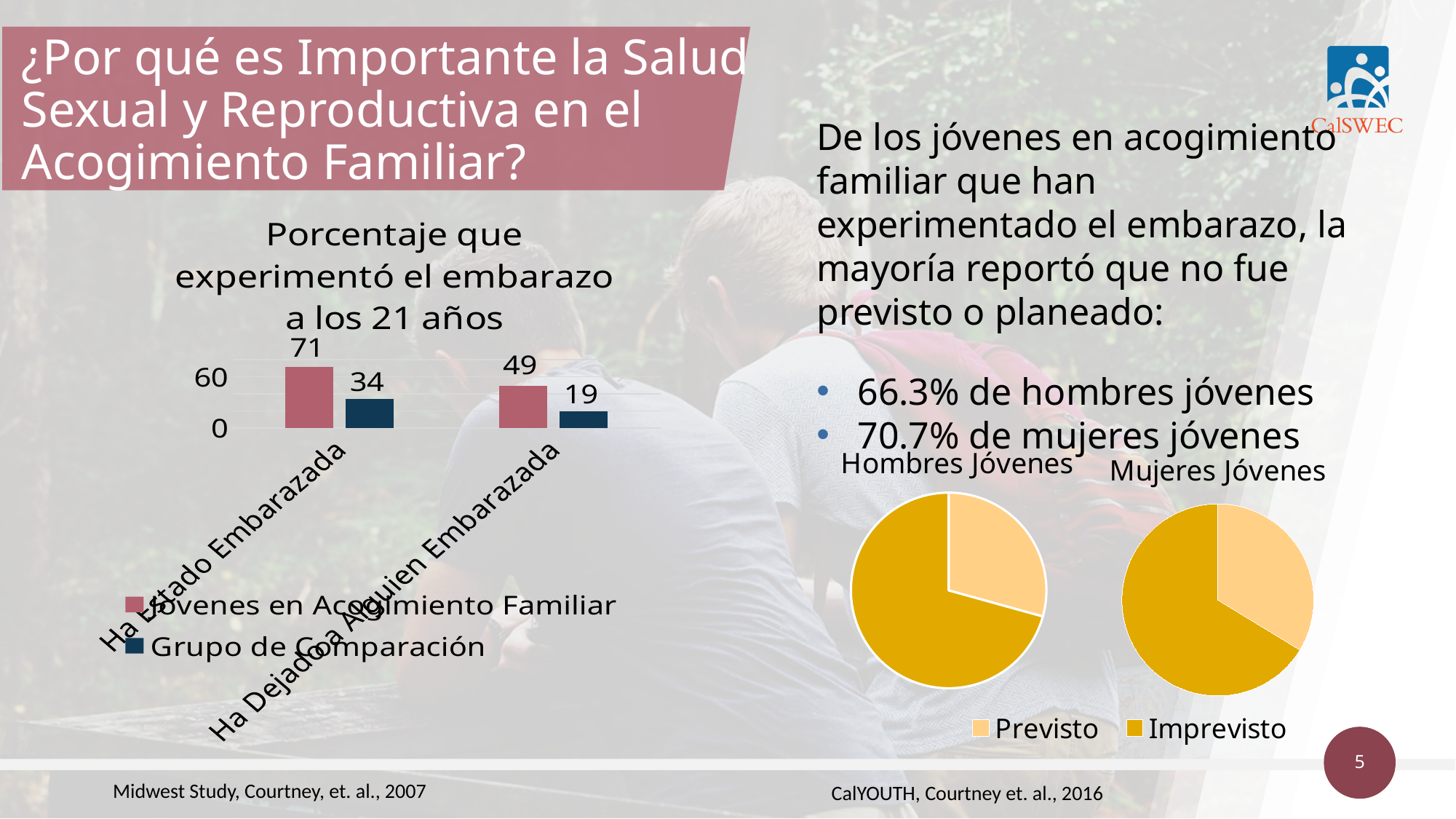
In the bar chart 'Porcentaje que experimentó el embarazo a los 21 años', what is the difference between Jóvenes en Acogimiento Familiar and Grupo de Comparación in the 'Ha Estado Embarazada' category? 37 In the bar chart 'Porcentaje que experimentó el embarazo a los 21 años', what is the value for Jóvenes en Acogimiento Familiar in the 'Ha Dejado a Alguien Embarazada' category? 49 What kind of chart is the 'Mujeres Jóvenes' chart on the right of the slide? Pie chart In the pie chart 'Hombres Jóvenes', which slice is larger, Previsto or Imprevisto? Imprevisto In the bar chart 'Porcentaje que experimentó el embarazo a los 21 años', what is the value for Jóvenes en Acogimiento Familiar in the 'Ha Estado Embarazada' category? 71 In the bar chart 'Porcentaje que experimentó el embarazo a los 21 años', how many series does the legend list? 2 In the bar chart 'Porcentaje que experimentó el embarazo a los 21 años', what is the difference between Jóvenes en Acogimiento Familiar and Grupo de Comparación in the 'Ha Dejado a Alguien Embarazada' category? 30 In the bar chart 'Porcentaje que experimentó el embarazo a los 21 años', which bar has the lowest value? Grupo de Comparación, Ha Dejado a Alguien Embarazada In the bar chart 'Porcentaje que experimentó el embarazo a los 21 años', how many categories are shown on the x axis? 2 In the bar chart 'Porcentaje que experimentó el embarazo a los 21 años', which bar has the highest value? Jóvenes en Acogimiento Familiar, Ha Estado Embarazada In the bar chart 'Porcentaje que experimentó el embarazo a los 21 años', what is the value for Grupo de Comparación in the 'Ha Dejado a Alguien Embarazada' category? 19 In the bar chart 'Porcentaje que experimentó el embarazo a los 21 años', what is the value for Grupo de Comparación in the 'Ha Estado Embarazada' category? 34